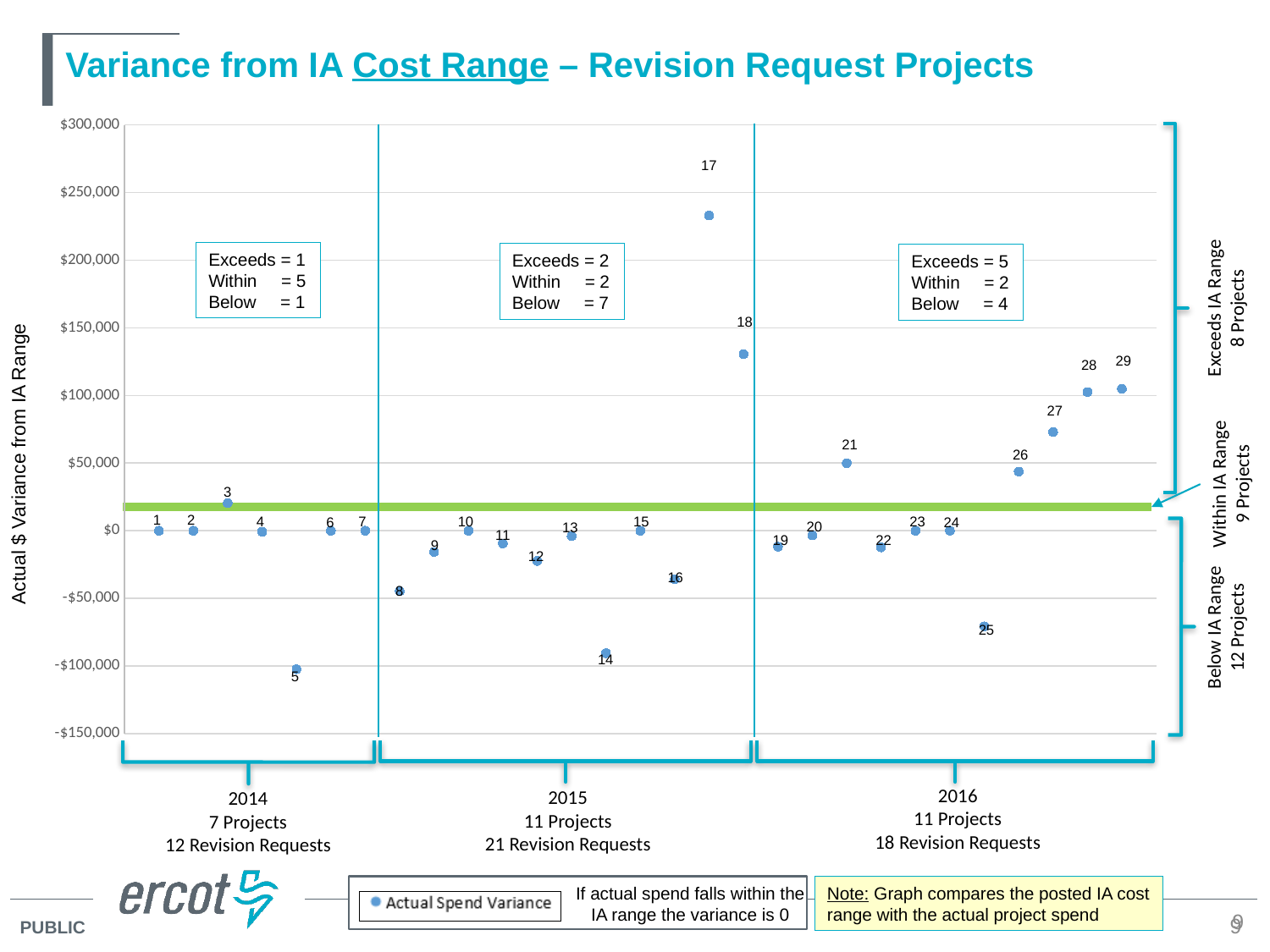
How many data points are plotted on the chart? 29 What kind of chart is shown on the slide? scatter chart Which has the larger variance, project 17 or project 18? project 17 Is the variance for project 17 greater or less than $200,000? greater What is the name of the series shown in the legend? Actual Spend Variance Is the variance for project 18 greater or less than $100,000? greater What is the variance value plotted for project 1? $0 How many series does the legend list? 1 Is the variance for project 14 greater or less than -$50,000? less Which numbered project has the lowest variance on the chart? 5 What is the title of the vertical axis? Actual $ Variance from IA Range Which numbered project has the highest variance on the chart? 17